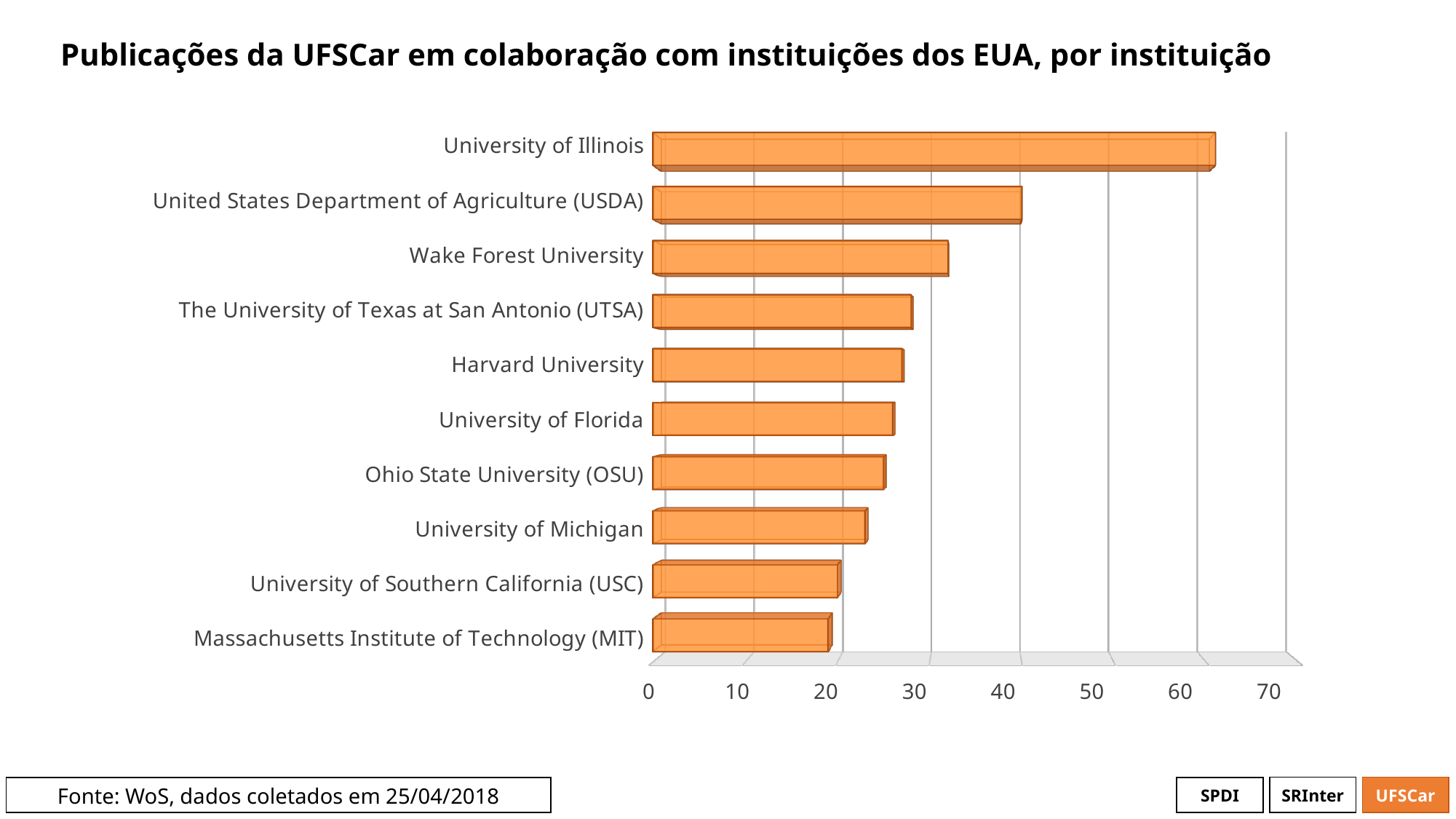
What is the title of the chart? Publicações da UFSCar em colaboração com instituições dos EUA, por instituição Is the value for Ohio State University (OSU) greater or less than 20? greater Is the value for Massachusetts Institute of Technology (MIT) greater or less than 30? less Which institution has the highest number of publications in collaboration with UFSCar? University of Illinois Is the value for Harvard University greater or less than 30? less How many institutions are shown in the chart? 10 Which has more publications: United States Department of Agriculture (USDA) or Wake Forest University? United States Department of Agriculture (USDA) What kind of chart is shown on the slide? bar chart Which has more publications: University of Michigan or The University of Texas at San Antonio (UTSA)? The University of Texas at San Antonio (UTSA)